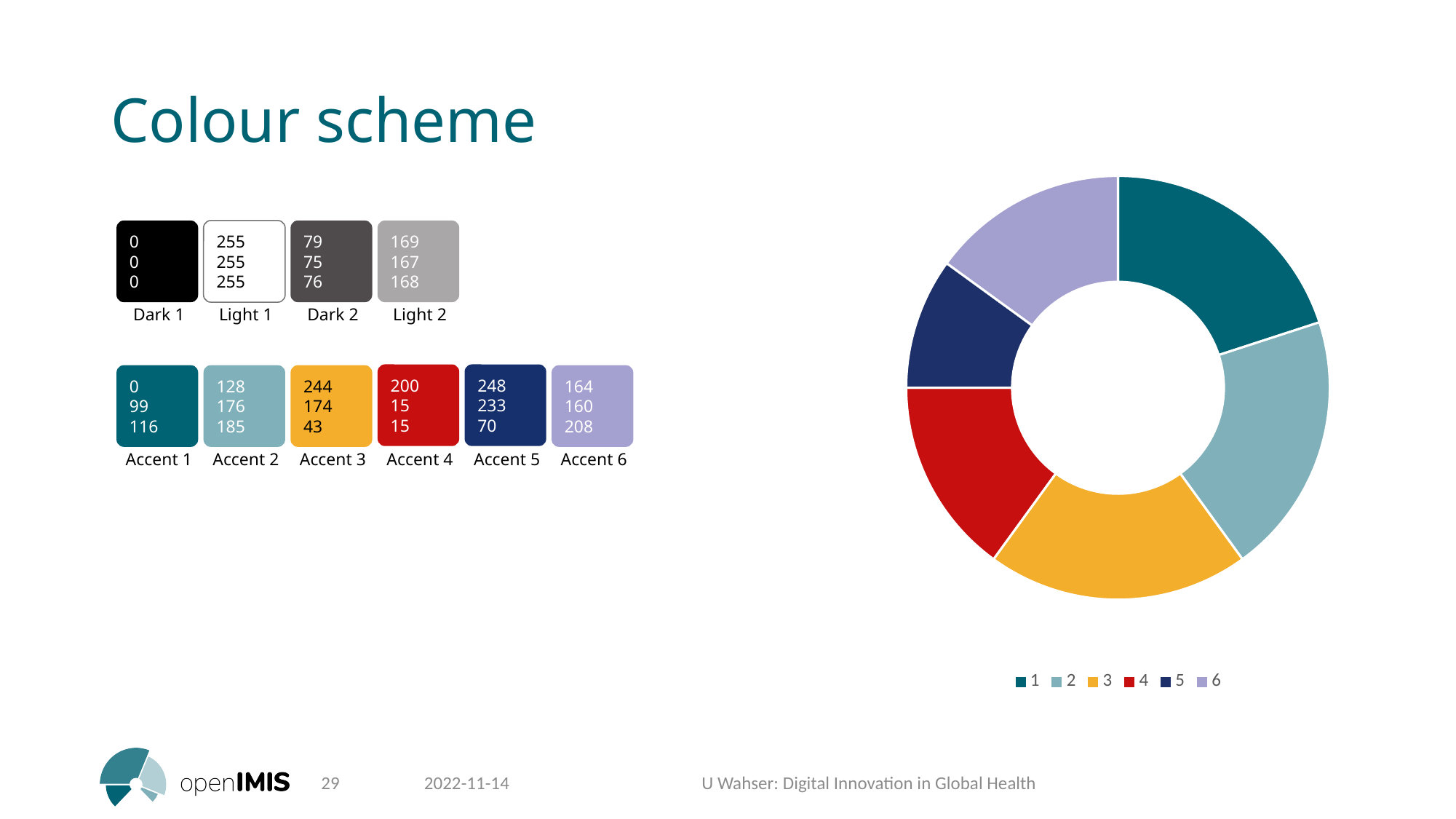
Which slice is larger in the doughnut chart, slice 3 or slice 6? 3 How many slices does the doughnut chart have? 6 Which slice is larger in the doughnut chart, slice 2 or slice 6? 2 How many entries does the legend of the doughnut chart list? 6 Which slice is larger in the doughnut chart, slice 1 or slice 5? 1 What kind of chart is shown on the slide? doughnut chart What colour is slice 3 in the doughnut chart? orange/yellow What are the legend entries of the doughnut chart? 1, 2, 3, 4, 5, 6